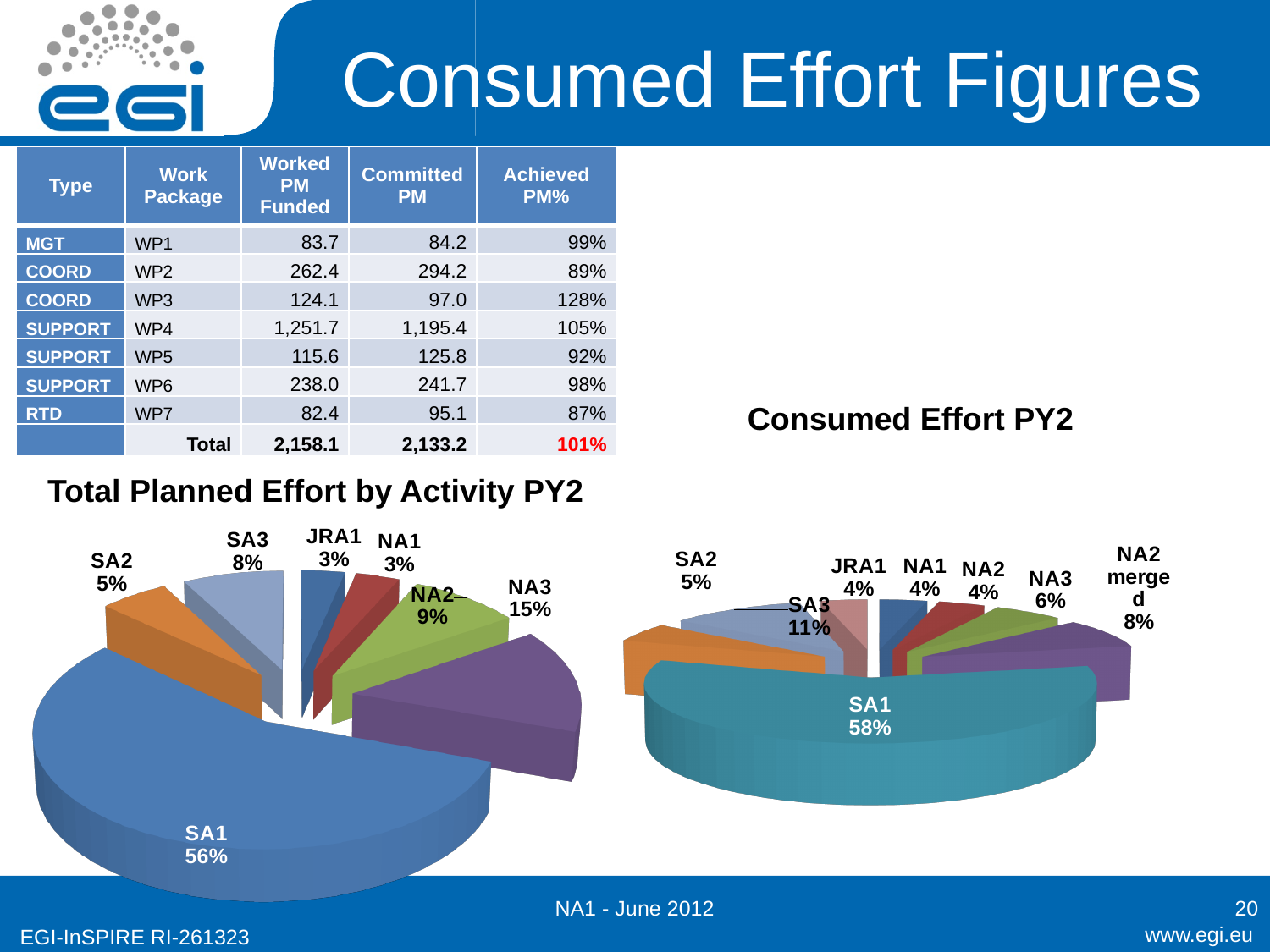
In the 'Consumed Effort PY2' chart, what share does 'NA2 merged' have? 8% What kind of chart is the 'Consumed Effort PY2' chart? Pie chart In the 'Total Planned Effort by Activity PY2' chart, what share does NA3 have? 15% What is the title of the pie chart on the left side of the slide? Total Planned Effort by Activity PY2 How many slices does the 'Consumed Effort PY2' chart have? 8 In the 'Total Planned Effort by Activity PY2' chart, which activity has the largest share? SA1 In the 'Consumed Effort PY2' chart, which activity has the largest share? SA1 In the 'Total Planned Effort by Activity PY2' chart, what share does SA1 have? 56% In the 'Total Planned Effort by Activity PY2' chart, what is the difference between the shares of NA3 and NA2? 6% In the 'Consumed Effort PY2' chart, what share does SA3 have? 11% How many slices does the 'Total Planned Effort by Activity PY2' chart have? 7 In the 'Consumed Effort PY2' chart, which is larger, the share of SA3 or the share of NA3? SA3